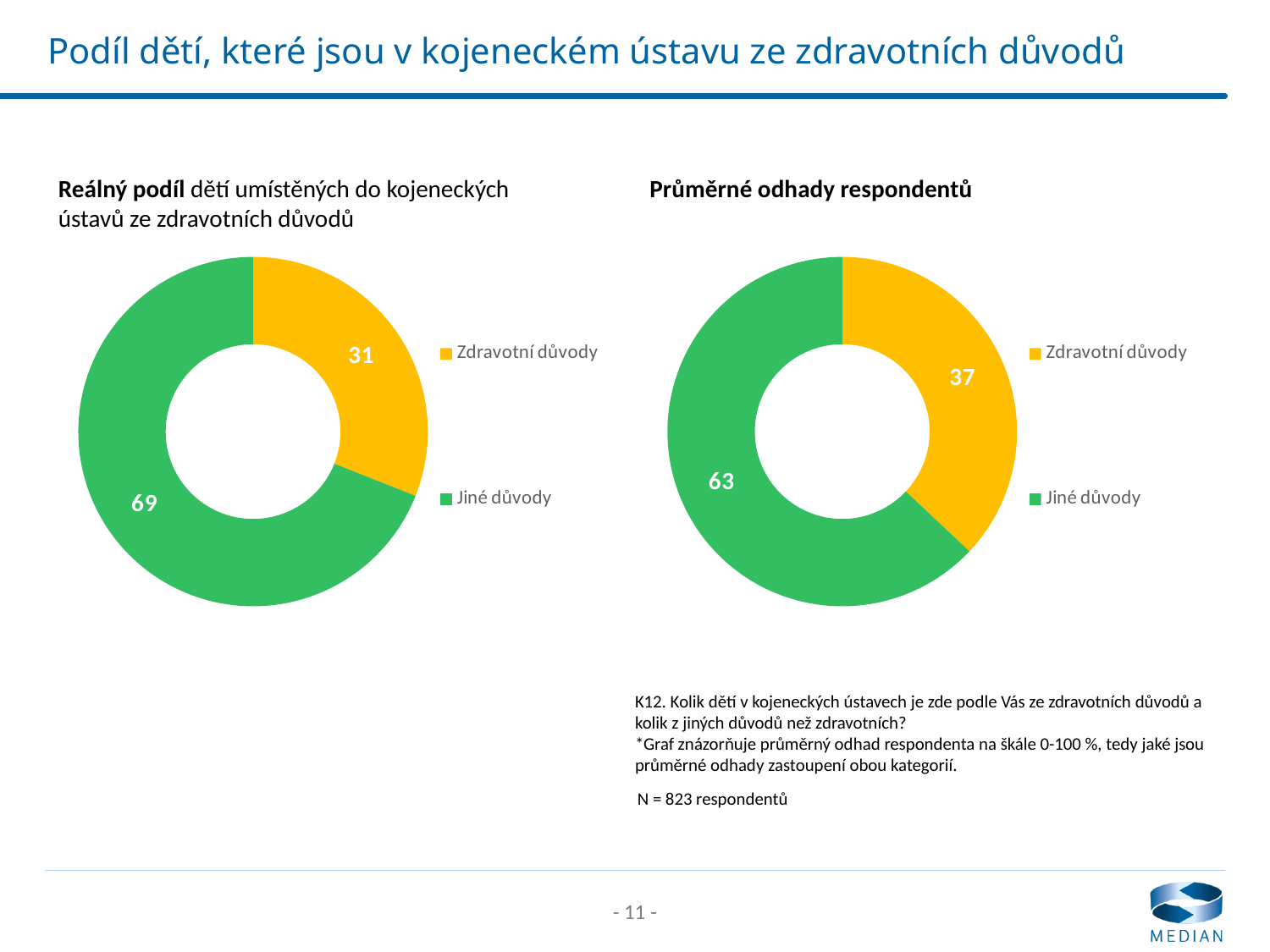
In the right chart (Průměrné odhady respondentů), what colour represents Jiné důvody? Green In the right chart (Průměrné odhady respondentů), what is the value for Jiné důvody? 63 In the right chart (Průměrné odhady respondentů), which category has the smallest share? Zdravotní důvody In the left chart (Reálný podíl), what is the value for Jiné důvody? 69 What type of chart is used on the left (Reálný podíl)? Doughnut (pie) chart In the left chart (Reálný podíl), what is the value for Zdravotní důvody? 31 Is the Zdravotní důvody value larger in the left chart (Reálný podíl) or in the right chart (Průměrné odhady respondentů)? Right chart (Průměrné odhady respondentů) In the right chart (Průměrné odhady respondentů), what is the value for Zdravotní důvody? 37 In the left chart (Reálný podíl), which category has the largest share? Jiné důvody How many categories does the right chart (Průměrné odhady respondentů) show? 2 In the left chart (Reálný podíl), what is the difference between Jiné důvody and Zdravotní důvody? 38 What is the difference between the Zdravotní důvody value in the right chart (Průměrné odhady respondentů) and the Zdravotní důvody value in the left chart (Reálný podíl)? 6